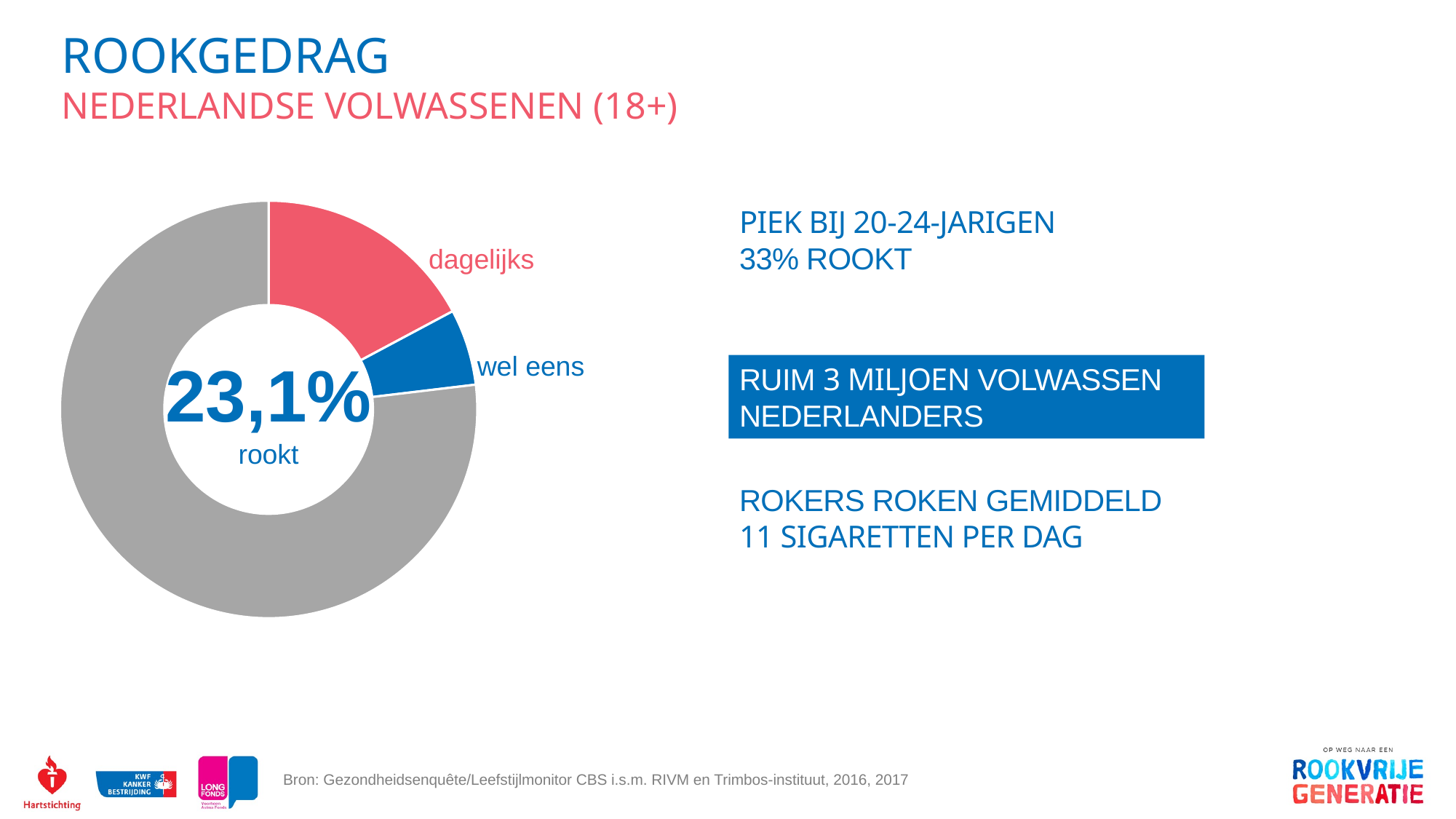
According to the text in the centre of the chart, what share of Dutch adults (18+) smokes? 23,1% What percentage is printed in the centre of the donut chart? 23,1% Is the grey (unlabelled) slice larger or smaller than the red 'dagelijks' slice? larger What colour is the 'wel eens' slice of the donut chart? blue How many slices does the donut chart have in total? 3 How many slices of the donut chart carry a text label? 2 Which of the two labelled slices is larger, 'dagelijks' or 'wel eens'? dagelijks Which labelled slice of the donut chart is the smallest? wel eens What kind of chart is shown on the slide? pie chart (donut) What colour is the 'dagelijks' slice of the donut chart? red